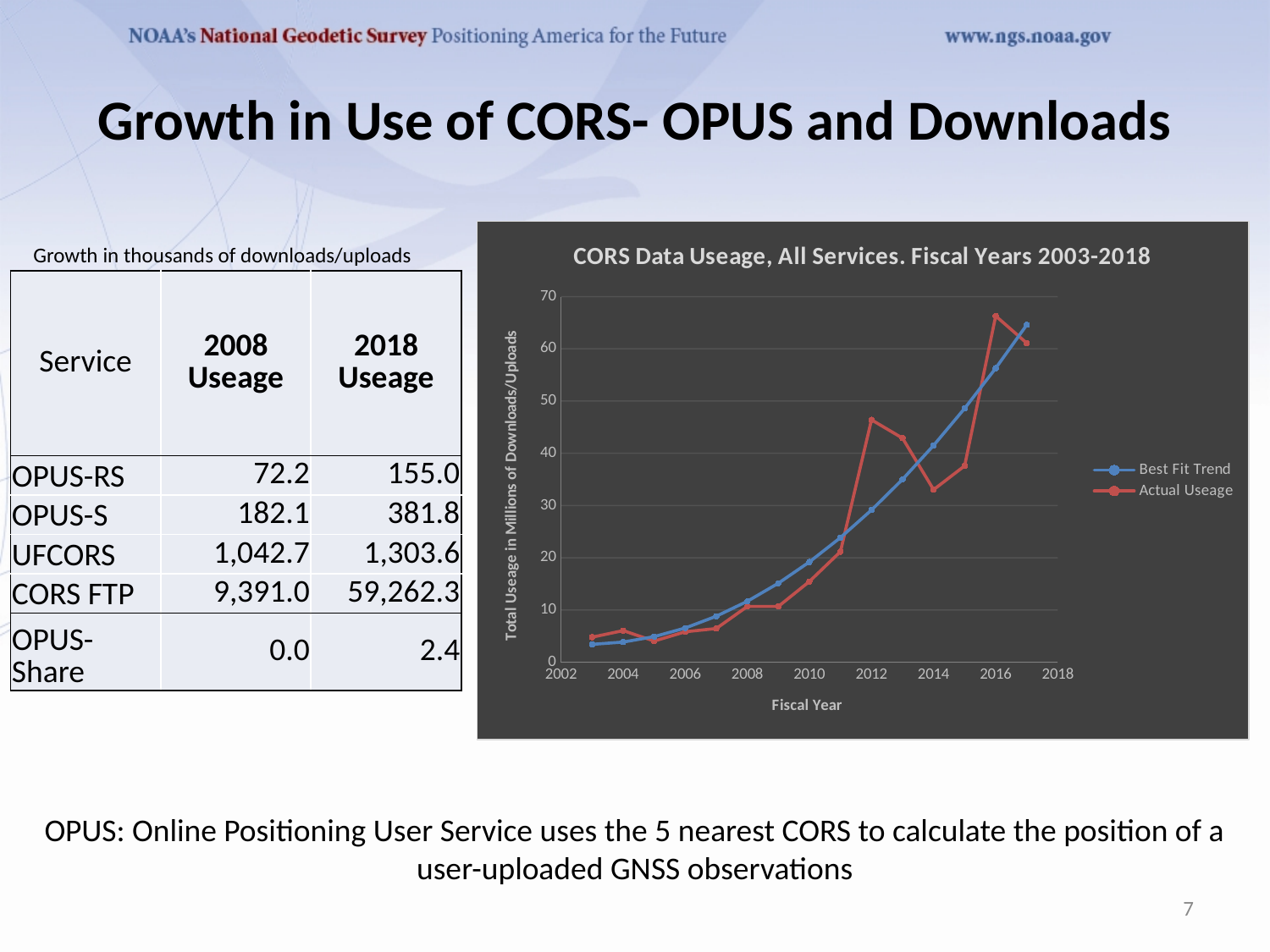
What are the two series named in the chart's legend? Best Fit Trend and Actual Useage Is the Best Fit Trend value for 2017 greater or less than 60? greater What kind of chart is shown on the slide? line chart How many series does the chart's legend list? 2 In which fiscal year does the Actual Useage series reach its highest value? 2016 Is the Actual Useage value for 2003 greater or less than 10? less Is the Actual Useage value for 2012 greater or less than 40? greater What is the title of the chart? CORS Data Useage, All Services. Fiscal Years 2003-2018 In 2012, which series has the higher value, Best Fit Trend or Actual Useage? Actual Useage In 2014, which series has the higher value, Best Fit Trend or Actual Useage? Best Fit Trend